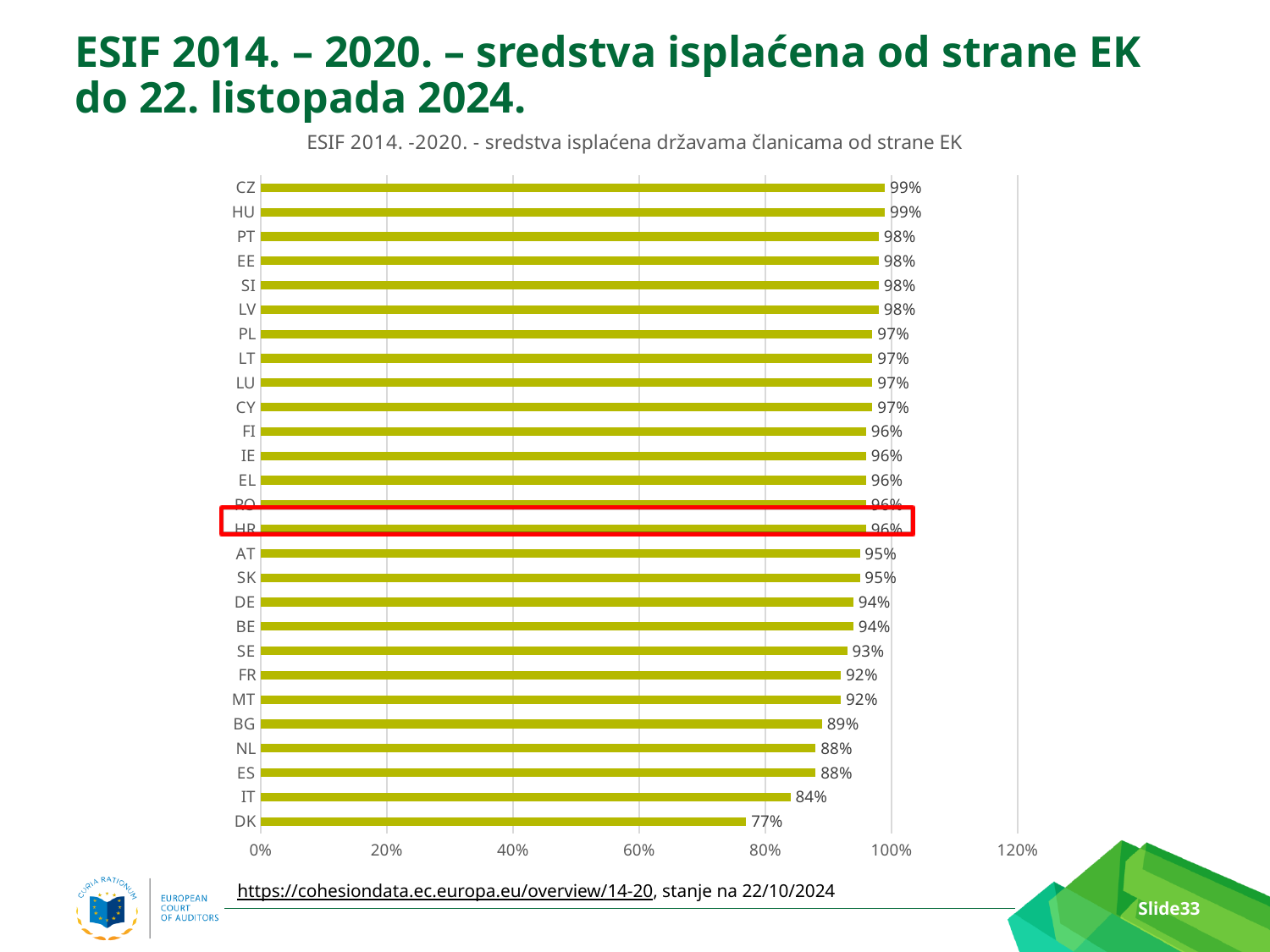
What type of chart is shown on the slide? Bar chart Is the value for DK greater or less than 80%? less How many countries are shown in the chart? 27 What is the difference between the values for BG and IT? 5% What is the value for IT? 84% What is the value for SE? 93% Which has a larger value, FR or NL? FR What is the value for DK? 77% Which country has the lowest value? DK What is the difference between the values for CZ and DK? 22% What is the title of the chart? ESIF 2014. -2020. - sredstva isplaćena državama članicama od strane EK What is the value for CZ? 99%